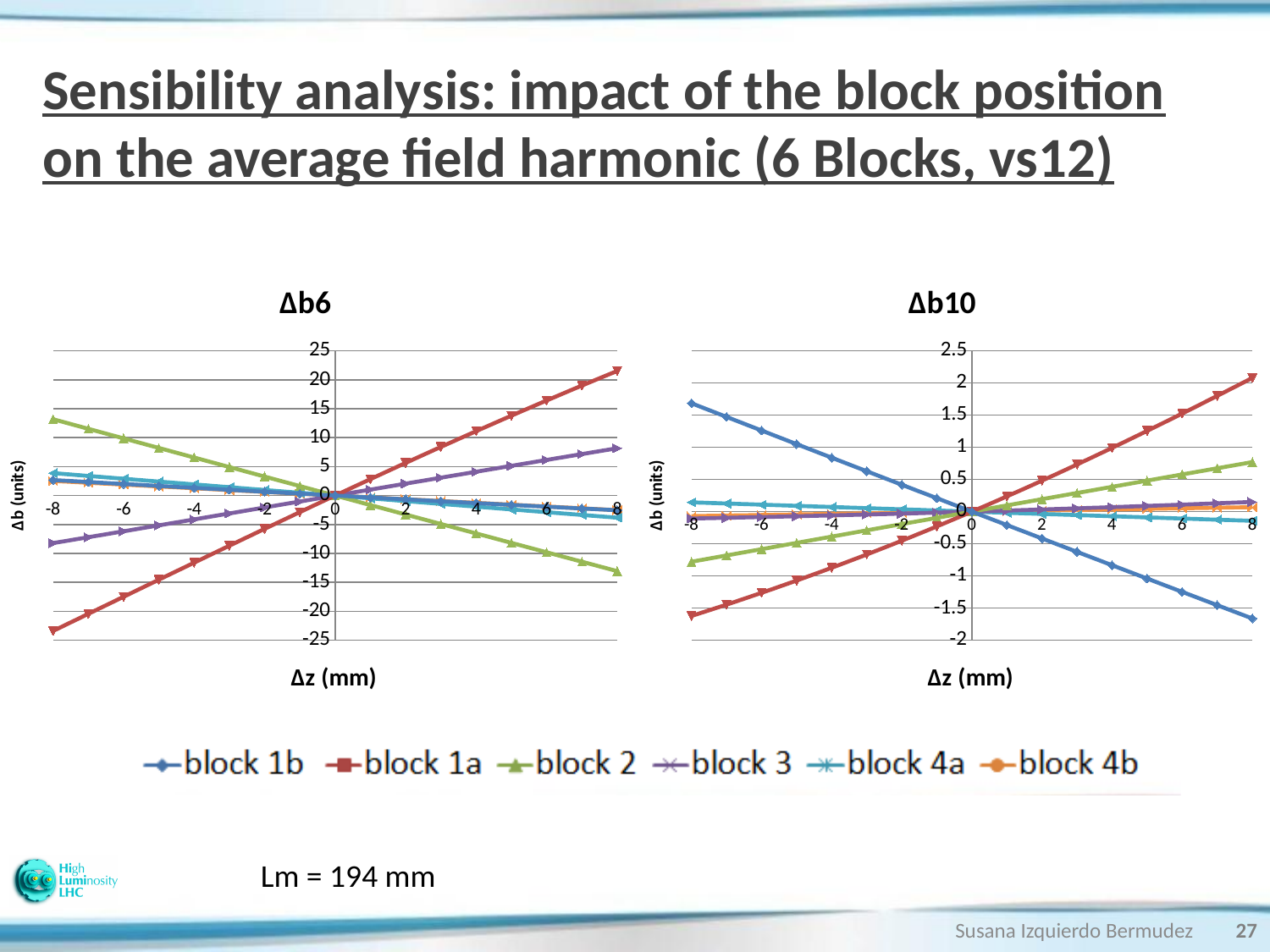
In the Δb10 chart, does the value for block 1b rise or fall as Δz increases from -8 to 8? fall In the Δb6 chart, which series has the highest value at Δz = 8? block 1a In the Δb6 chart, is the value for block 1a at Δz = 8 greater or less than 20? greater In the Δb6 chart, is the value for block 2 at Δz = -8 greater or less than 10? greater In the Δb6 chart, does the value for block 1a rise or fall as Δz increases from -8 to 8? rise In the Δb6 chart, does the value for block 2 rise or fall as Δz increases from -8 to 8? fall In the Δb6 chart, at Δz = 8, which is larger: the value for block 1a or the value for block 3? block 1a In the Δb10 chart, is the value for block 1b at Δz = -8 greater or less than 1.5? greater How many series does the shared legend list? 6 What kind of chart is the Δb6 chart? line chart In the Δb10 chart, which series has the lowest value at Δz = 8? block 1b